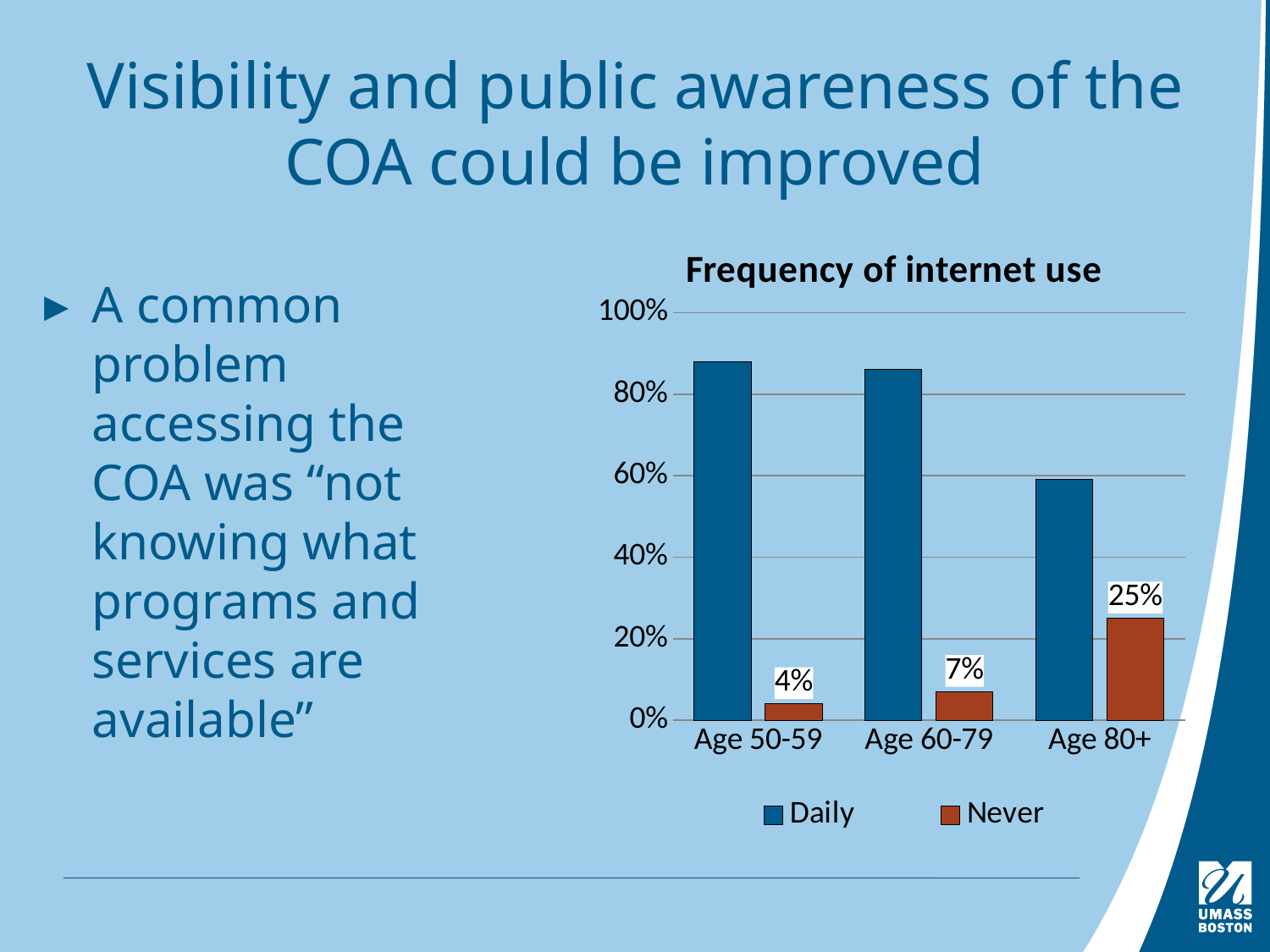
Is the Daily value for Age 80+ greater or less than 80%? less How many age categories are shown on the x axis? 3 Which age group has the highest Never value? Age 80+ What is the title of the chart? Frequency of internet use How many series does the legend list? 2 What is the value for Never in the Age 80+ category? 25% What is the value for Never in the Age 50-59 category? 4% What is the value for Never in the Age 60-79 category? 7% Is the Daily value for Age 50-59 greater or less than 80%? greater What is the difference between the Never values for Age 80+ and Age 50-59? 21% Which age group has the lowest Never value? Age 50-59 Which age group has the lowest Daily value? Age 80+